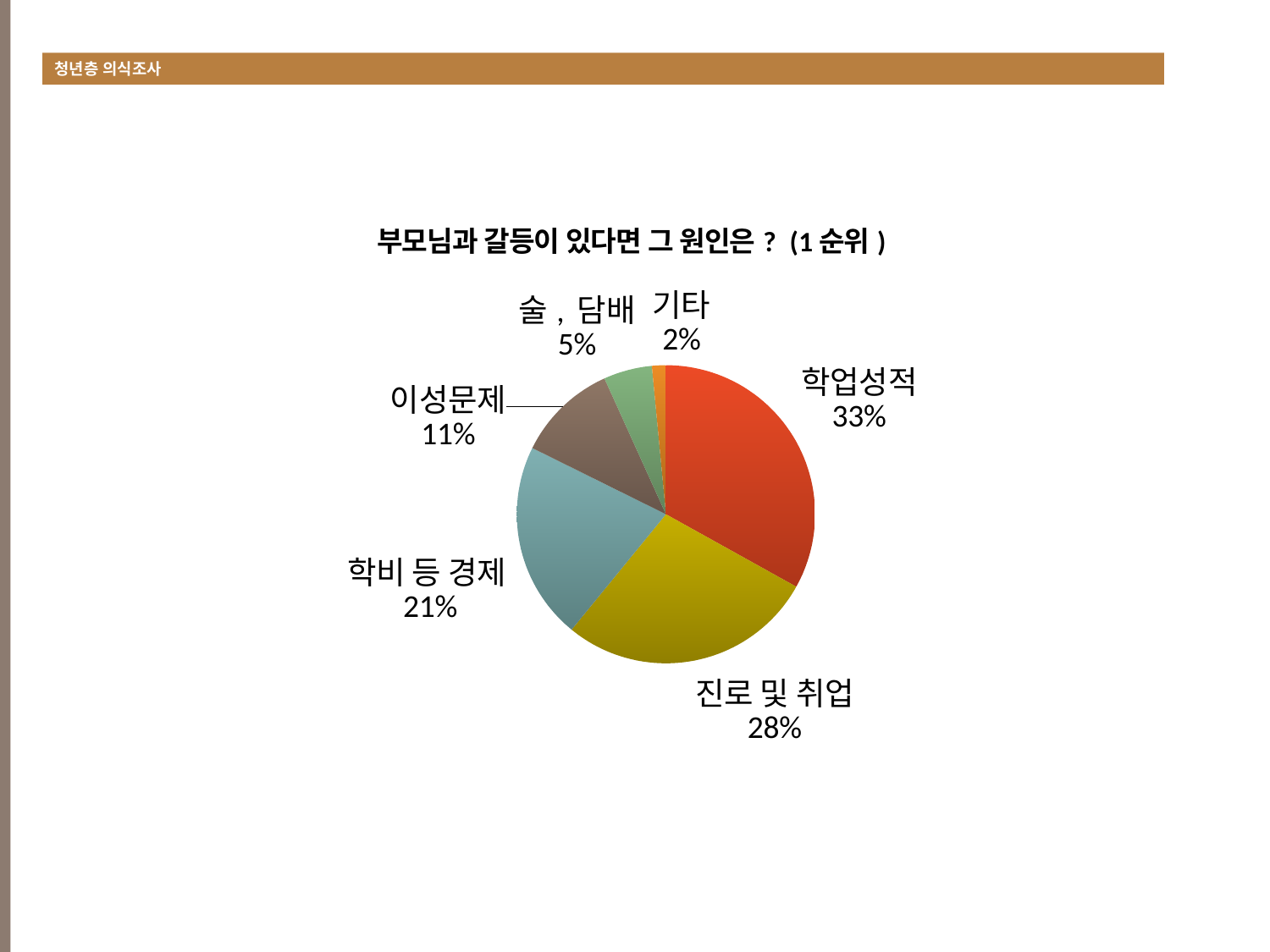
What is the difference between the values for 학업성적 and 진로 및 취업? 5% What is the title of the chart? 부모님과 갈등이 있다면 그 원인은 ? (1 순위 ) What share of the pie does 학업성적 take? 33% Which is larger, 학비 등 경제 or 이성문제? 학비 등 경제 What is the value for 술 , 담배? 5% What is the value for 학비 등 경제? 21% Which category has the smallest slice? 기타 What is the value for 이성문제? 11% How many categories are shown in the pie chart? 6 Which category has the largest slice? 학업성적 What kind of chart is shown on the slide? pie chart What is the value for 진로 및 취업? 28%